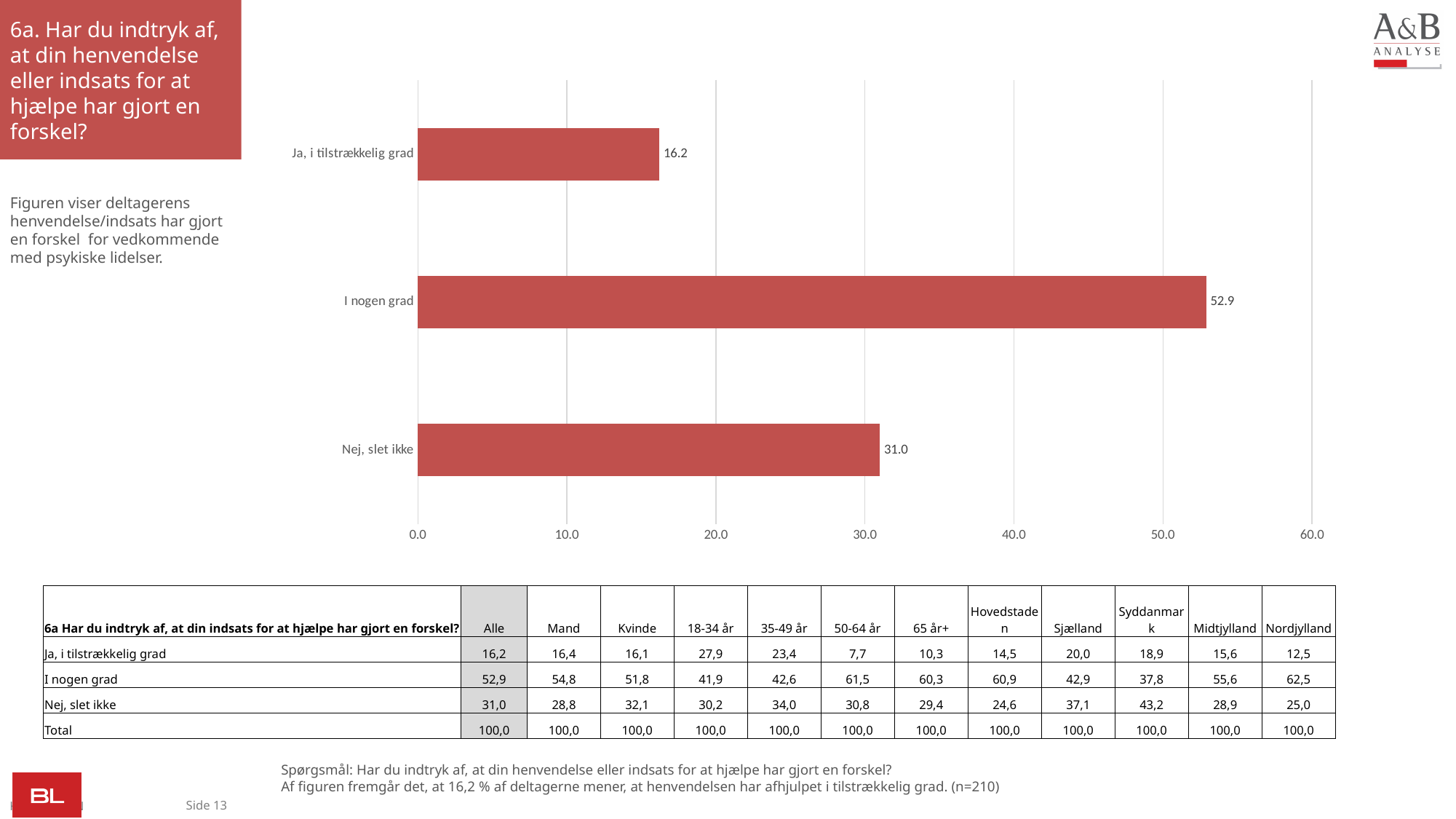
What is the value for "I nogen grad"? 52.9 Which category has the highest value? I nogen grad How many categories are shown in the chart? 3 Is the value for "I nogen grad" greater or less than 50.0? greater What is the value for "Ja, i tilstrækkelig grad"? 16.2 What is the difference between the values for "I nogen grad" and "Nej, slet ikke"? 21.9 What kind of chart is shown on the slide? bar chart Which category has the lowest value? Ja, i tilstrækkelig grad Which is larger, the value for "Nej, slet ikke" or the value for "Ja, i tilstrækkelig grad"? Nej, slet ikke What is the difference between the values for "Nej, slet ikke" and "Ja, i tilstrækkelig grad"? 14.8 What is the value for "Nej, slet ikke"? 31.0 What is the highest value shown on the x axis of the chart? 60.0